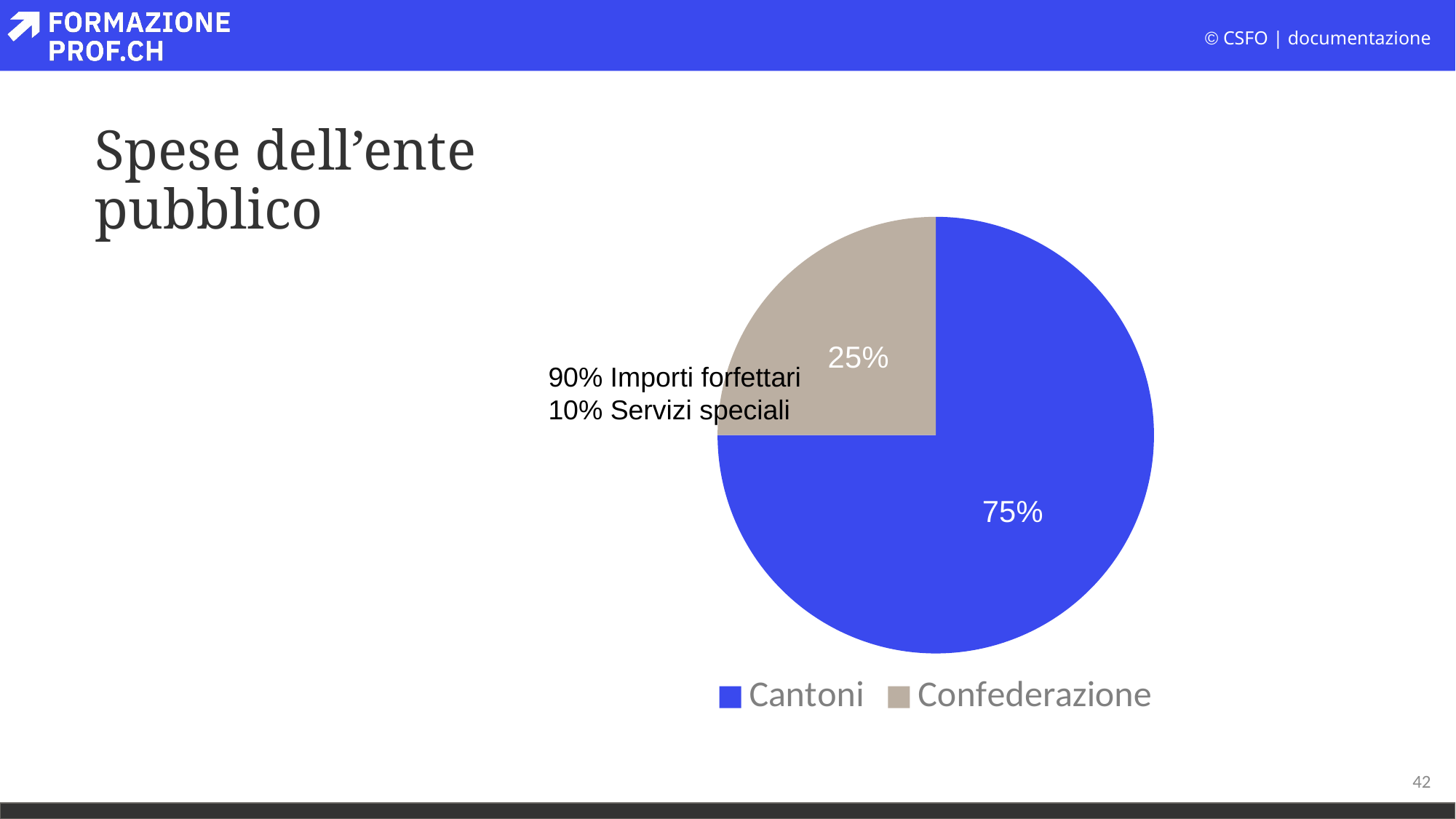
What kind of chart is shown on the slide? Pie chart What share of the pie does Cantoni account for? 75% How many slices does the pie chart have? 2 What is the total of the two slice percentages shown on the pie chart? 100% What is the title of the slide containing the pie chart? Spese dell'ente pubblico Which slice is larger, Cantoni or Confederazione? Cantoni What colour is the Confederazione slice? Beige/grey Which category has the largest slice of the pie? Cantoni How many entries does the legend list? 2 What is the difference in percentage points between the Cantoni and Confederazione slices? 50 Which category has the smallest slice of the pie? Confederazione What share of the pie does Confederazione account for? 25%